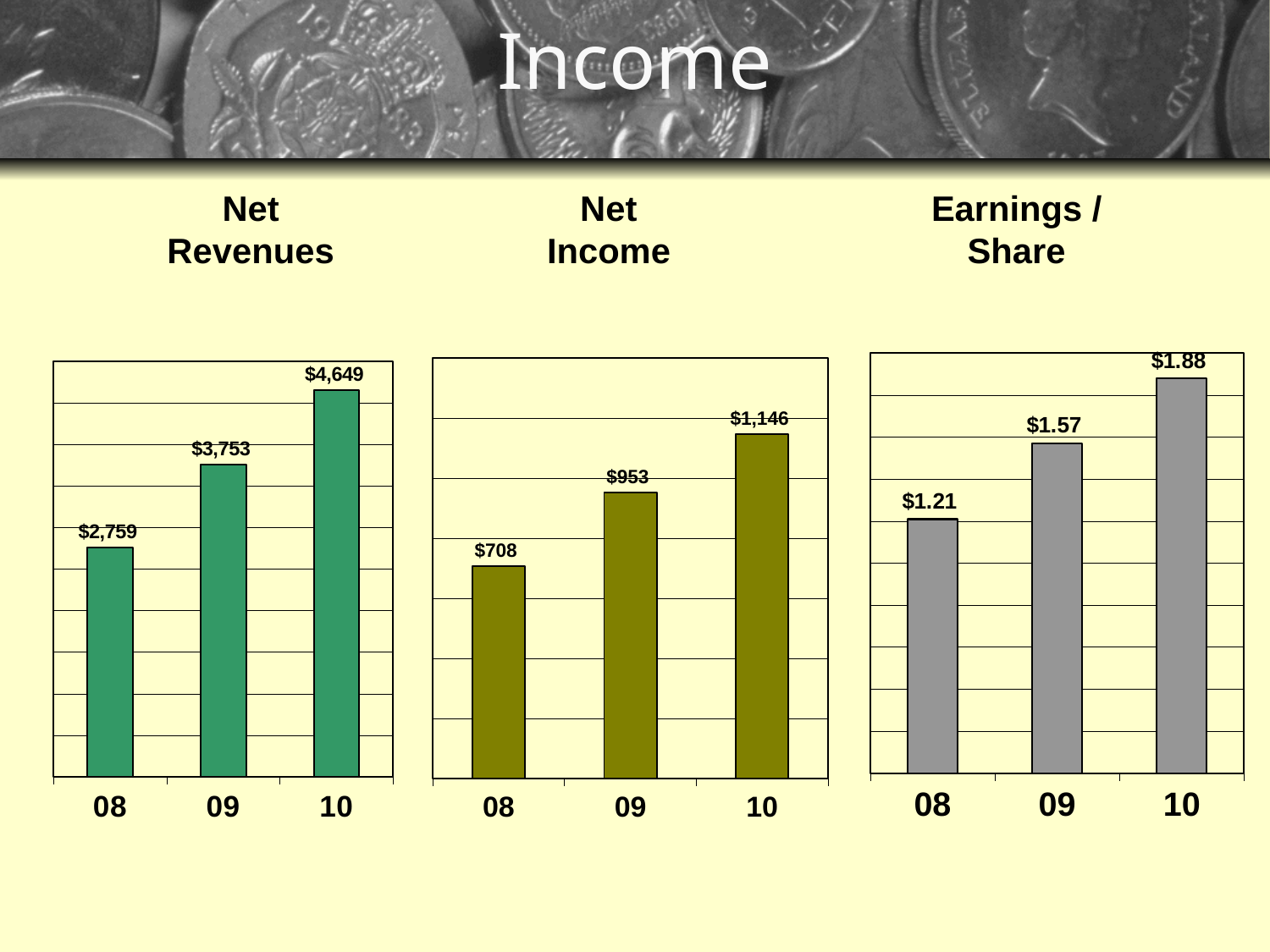
In the Net Revenues chart, which year has the highest value? 10 How many bars are in the Net Income chart? 3 In the Earnings / Share chart, what is the value for 10? $1.88 What kind of chart is the Net Revenues chart? bar chart In the Net Income chart, what is the difference between the values for 10 and 09? $193 In the Net Revenues chart, what is the value for 09? $3,753 In the Earnings / Share chart, what is the difference between the values for 09 and 08? $0.36 In the Net Income chart, which year has the lowest value? 08 In the Net Income chart, what is the value for 08? $708 In the Earnings / Share chart, do the values rise or fall from 08 to 10? rise In the Earnings / Share chart, which is larger, the value for 09 or the value for 10? 10 In the Net Revenues chart, what is the difference between the values for 10 and 08? $1,890